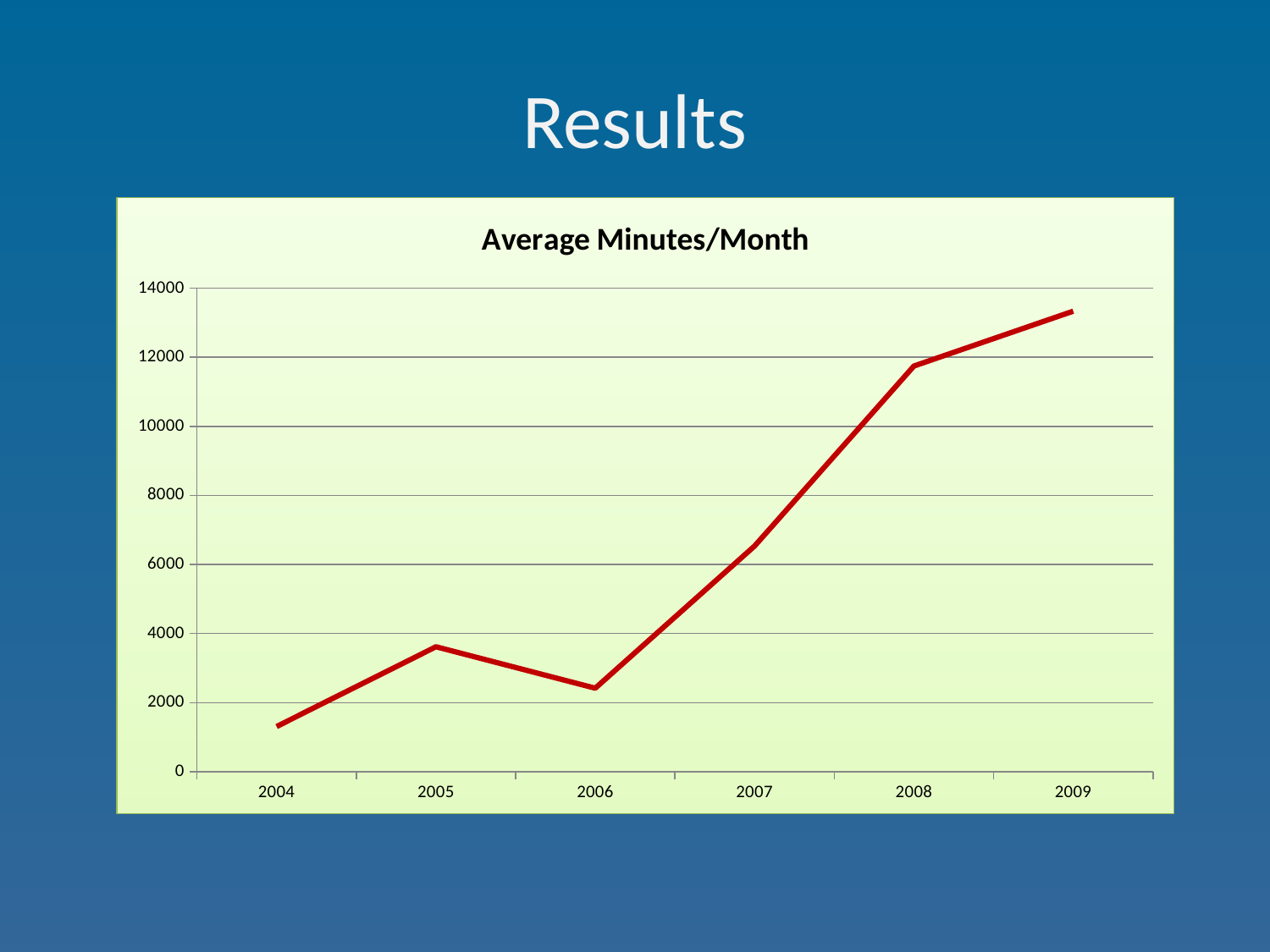
How many years are plotted on the x axis? 6 What is the title of the chart? Average Minutes/Month What type of chart is shown on the slide? line chart Is the value for 2004 greater or less than 2000? less Which year has the larger value, 2007 or 2008? 2008 Which year has the lowest value? 2004 Is the value for 2006 greater or less than 4000? less Is the value for 2007 greater or less than 6000? greater Which year has the larger value, 2005 or 2006? 2005 Do the values generally rise or fall from 2006 to 2009? rise Which year has the highest value? 2009